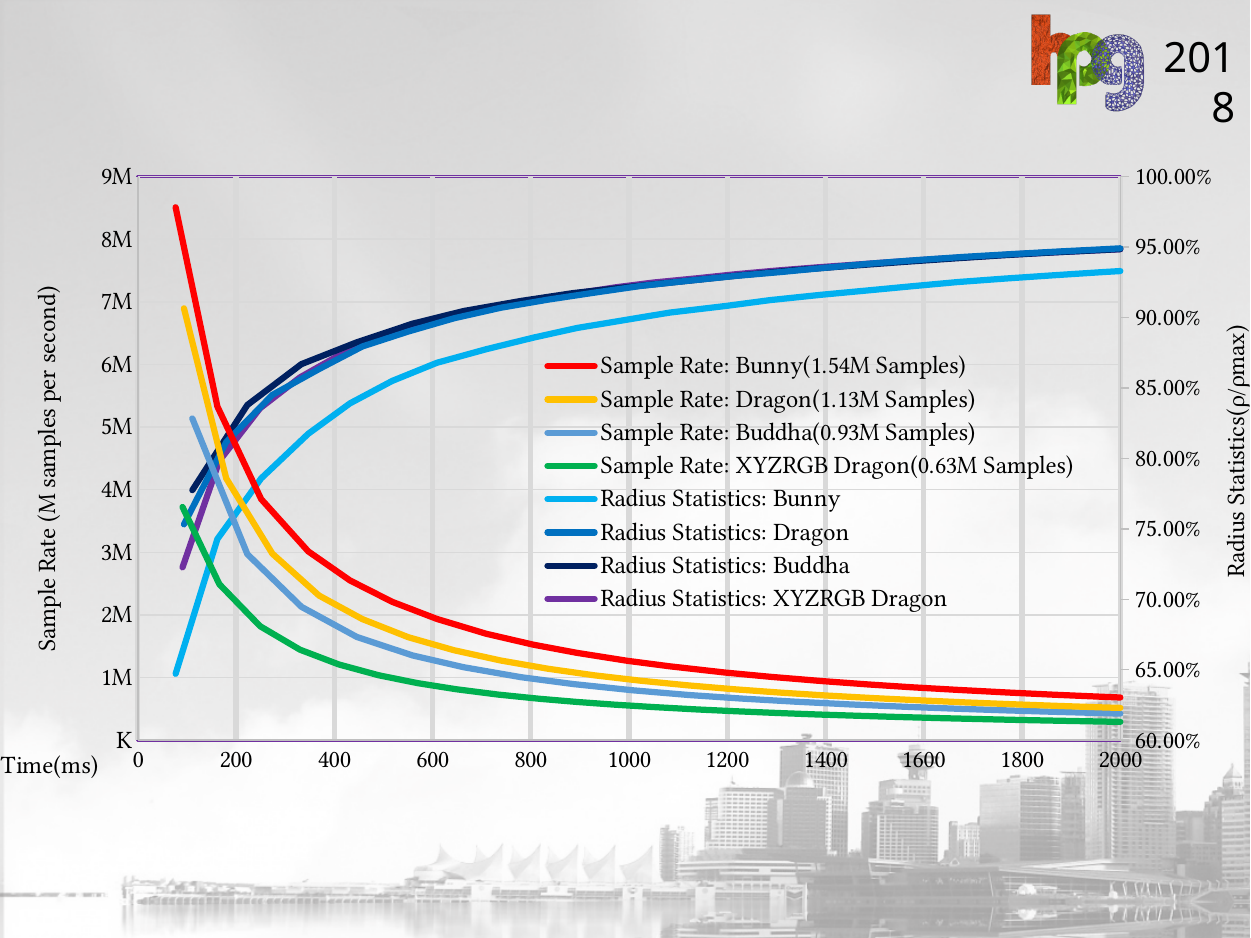
Is the starting value of Sample Rate: Bunny(1.54M Samples) greater or less than 8M? greater Is the value of Sample Rate: Bunny(1.54M Samples) at 2000 ms greater or less than 1M? less Do the Radius Statistics series rise or fall as Time(ms) increases? rise Which Sample Rate series has the highest value at the start of the chart? Sample Rate: Bunny(1.54M Samples) Is the value of Sample Rate: XYZRGB Dragon(0.63M Samples) at 2000 ms greater or less than 1M? less What kind of chart is shown on the slide? line chart What is the label of the left vertical axis? Sample Rate (M samples per second) How many series does the legend list? 8 Do the Sample Rate series rise or fall as Time(ms) increases? fall At 2000 ms, which is larger: Sample Rate: Bunny(1.54M Samples) or Sample Rate: XYZRGB Dragon(0.63M Samples)? Sample Rate: Bunny(1.54M Samples)